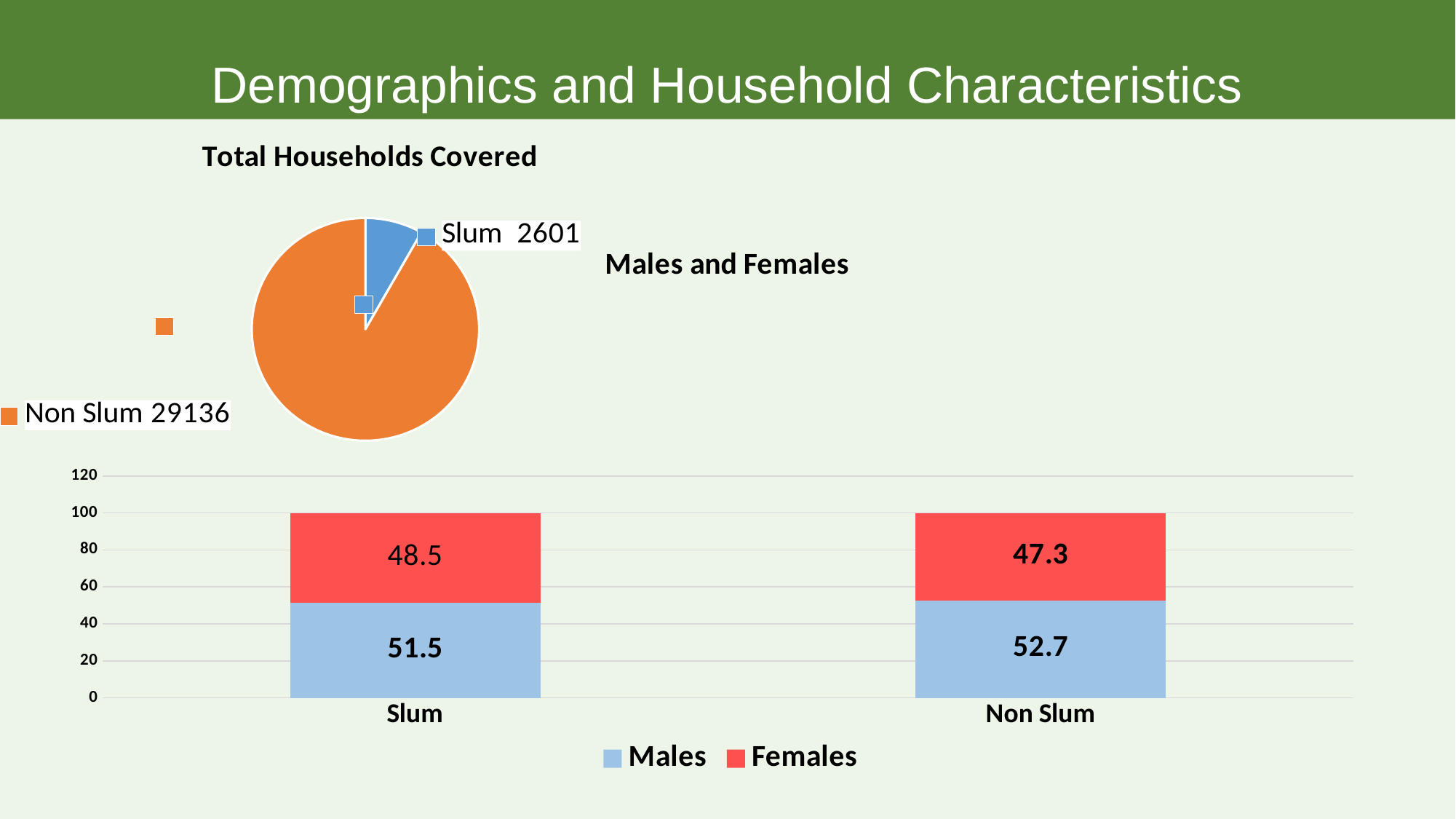
In the 'Males and Females' chart, what is the total of the stacked bar for Non Slum? 100 What kind of chart is 'Males and Females'? Stacked bar chart In the 'Total Households Covered' pie chart, what is the value for Non Slum? 29136 In the 'Males and Females' chart, what is the Females value for Non Slum? 47.3 In the 'Males and Females' chart, which is larger for Non Slum: Males or Females? Males In the 'Males and Females' chart, what is the difference between the Males and Females values for Slum? 3.0 In the 'Males and Females' chart, what is the Males value for Slum? 51.5 How many series does the legend of the 'Males and Females' chart list? 2 In the 'Total Households Covered' pie chart, what is the value for Slum? 2601 What kind of chart is 'Total Households Covered'? Pie chart In the 'Total Households Covered' pie chart, what is the difference between the Non Slum and Slum values? 26535 In the 'Total Households Covered' pie chart, which category has the larger slice? Non Slum